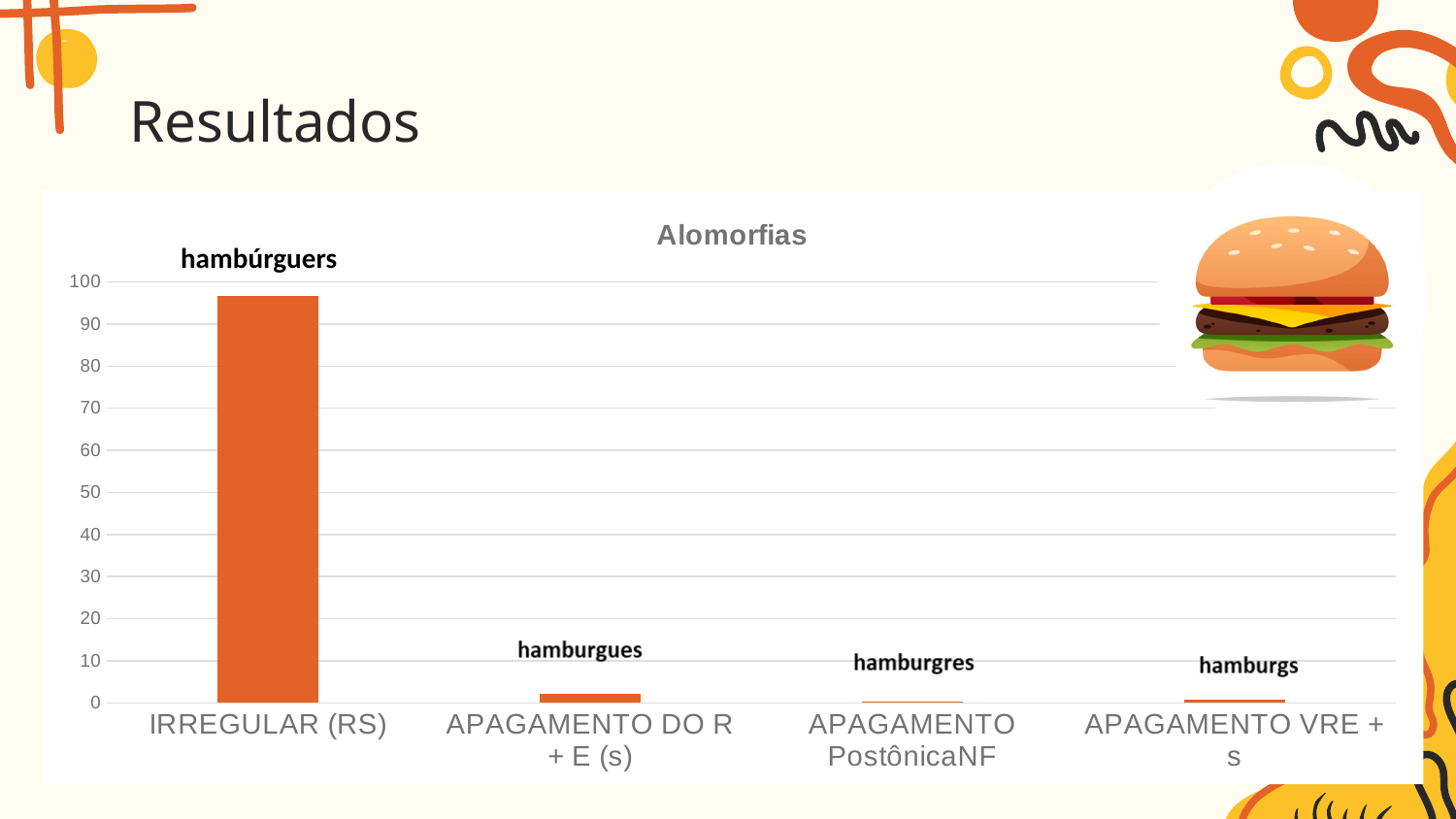
How many categories are shown on the x axis of the chart? 4 Is the value for IRREGULAR (RS) greater or less than 90? greater Which is larger, the value for APAGAMENTO DO R + E (s) or the value for APAGAMENTO PostônicaNF? APAGAMENTO DO R + E (s) Is the value for APAGAMENTO DO R + E (s) greater or less than 10? less What word is written above the bar for IRREGULAR (RS)? hambúrguers Which category has the highest bar in the chart? IRREGULAR (RS) Is the value for APAGAMENTO VRE + s greater or less than 10? less Which is larger, the value for IRREGULAR (RS) or the value for APAGAMENTO DO R + E (s)? IRREGULAR (RS) What is the highest value shown on the y axis of the chart? 100 What is the title of the chart? Alomorfias What kind of chart is shown on the slide? bar chart